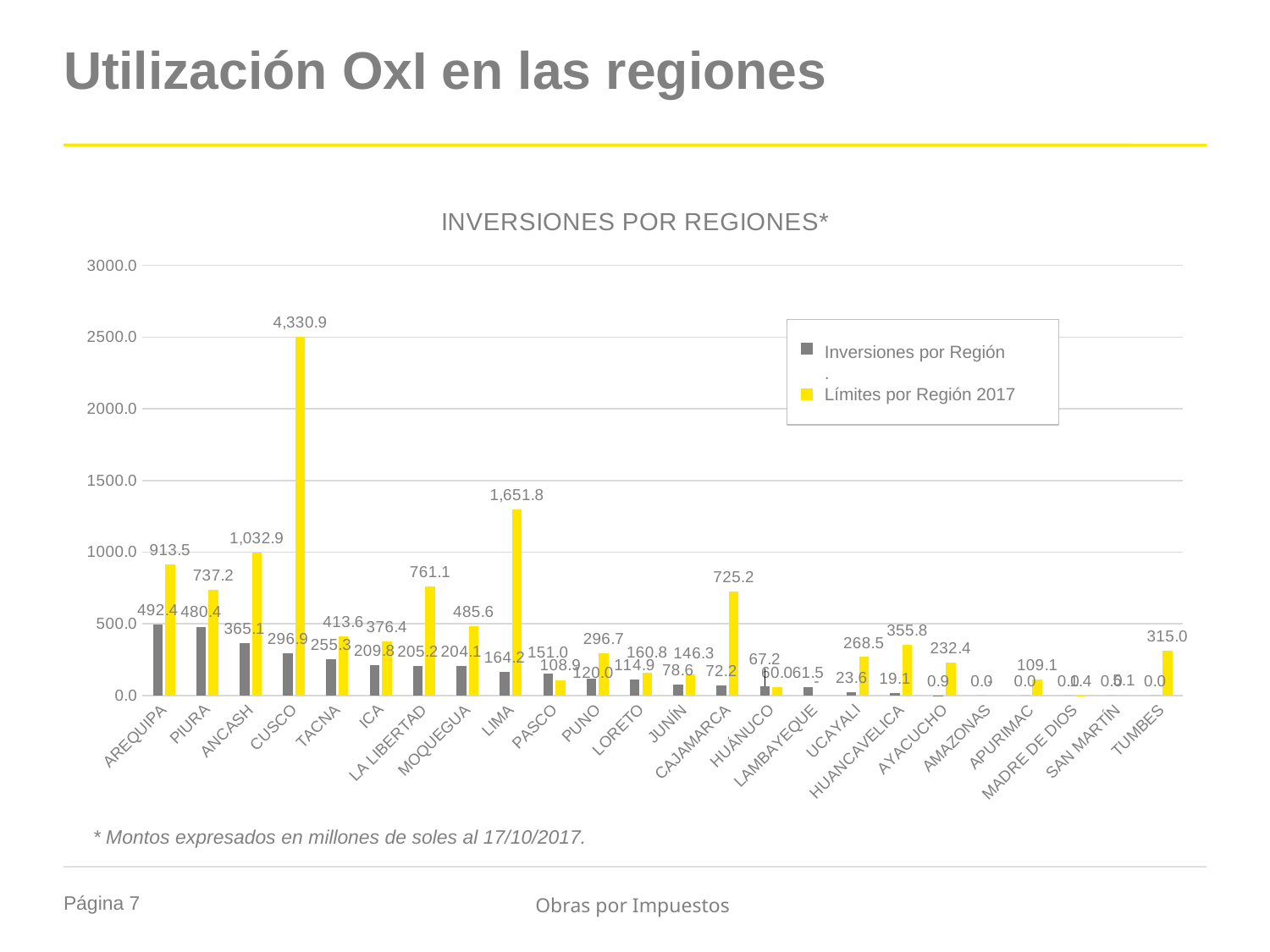
What is the value of Límites por Región 2017 for CAJAMARCA? 725.2 How many regions are shown on the x axis? 24 What kind of chart is shown on the slide? Bar chart What is the difference between the Límites por Región 2017 and Inversiones por Región values for ANCASH? 667.8 Which region has the highest Inversiones por Región value? AREQUIPA What is the value of Límites por Región 2017 for LIMA? 1,651.8 What is the title of the chart? INVERSIONES POR REGIONES* What is the value of Inversiones por Región for AREQUIPA? 492.4 Which is larger for PASCO: Inversiones por Región or Límites por Región 2017? Inversiones por Región Is the Límites por Región 2017 value for LA LIBERTAD greater or less than 500? greater Which region has the highest Límites por Región 2017 value? CUSCO How many series does the legend list? 2